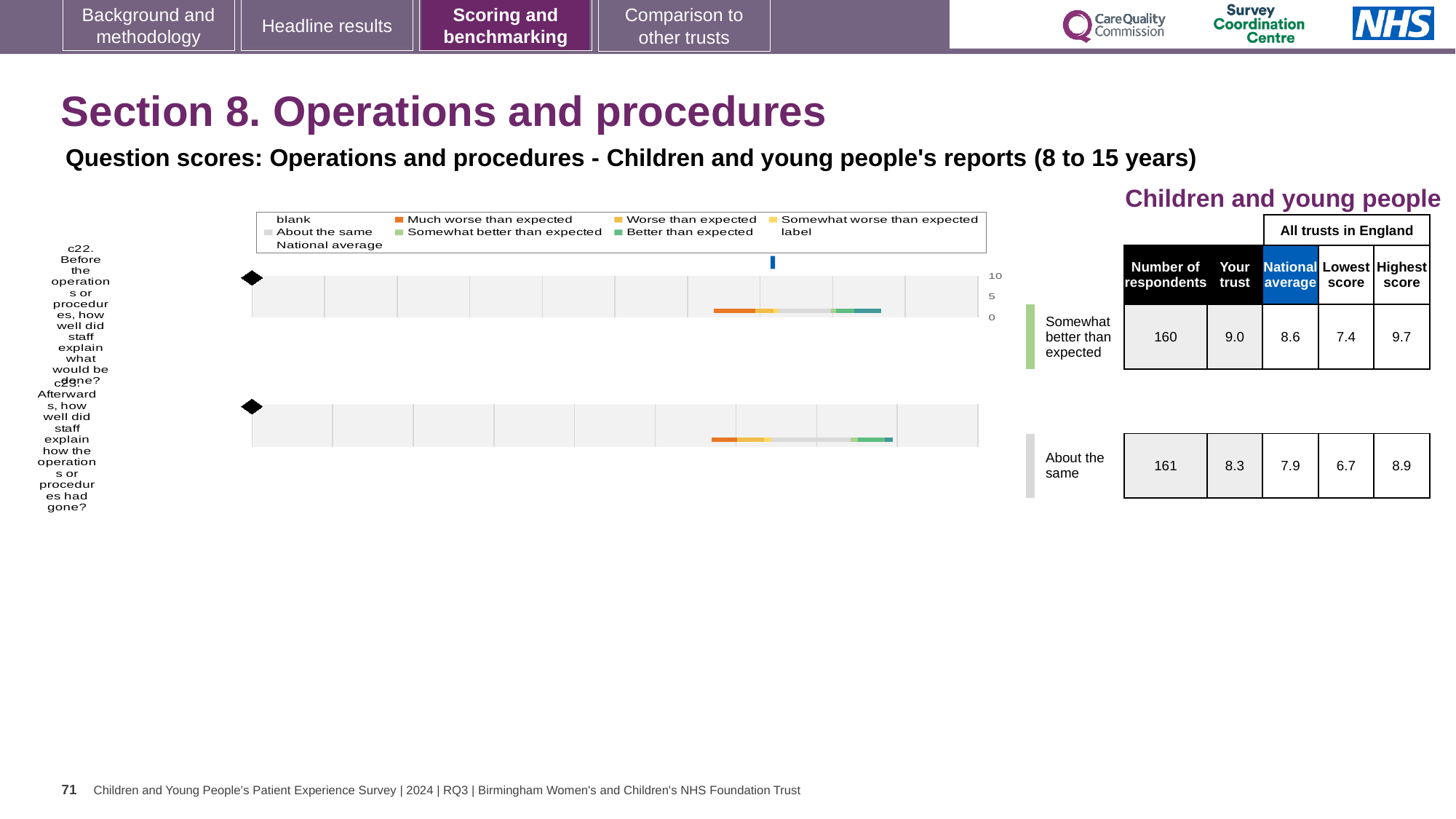
Which of the two questions has the higher 'Your trust' score? c22 For question c22, which is larger: the 'Your trust' score or the national average? Your trust What is the lowest score among all trusts in England for question c23? 6.7 What is the national average score for question c23 (how well staff explained how the operation had gone)? 7.9 How many respondents answered question c23? 161 Which benchmarking band is question c22 placed in? Somewhat better than expected How many questions (rows) are plotted in the benchmarking chart? 2 What is the 'Your trust' score for question c22 (how well staff explained what would be done before the operation)? 9.0 What is the difference between the highest and lowest scores for question c23? 2.2 What kind of chart is used to show the benchmarking bands for the operations and procedures questions? Bar chart What is the highest score among all trusts in England for question c22? 9.7 What is the difference between the 'Your trust' score and the national average for question c22? 0.4